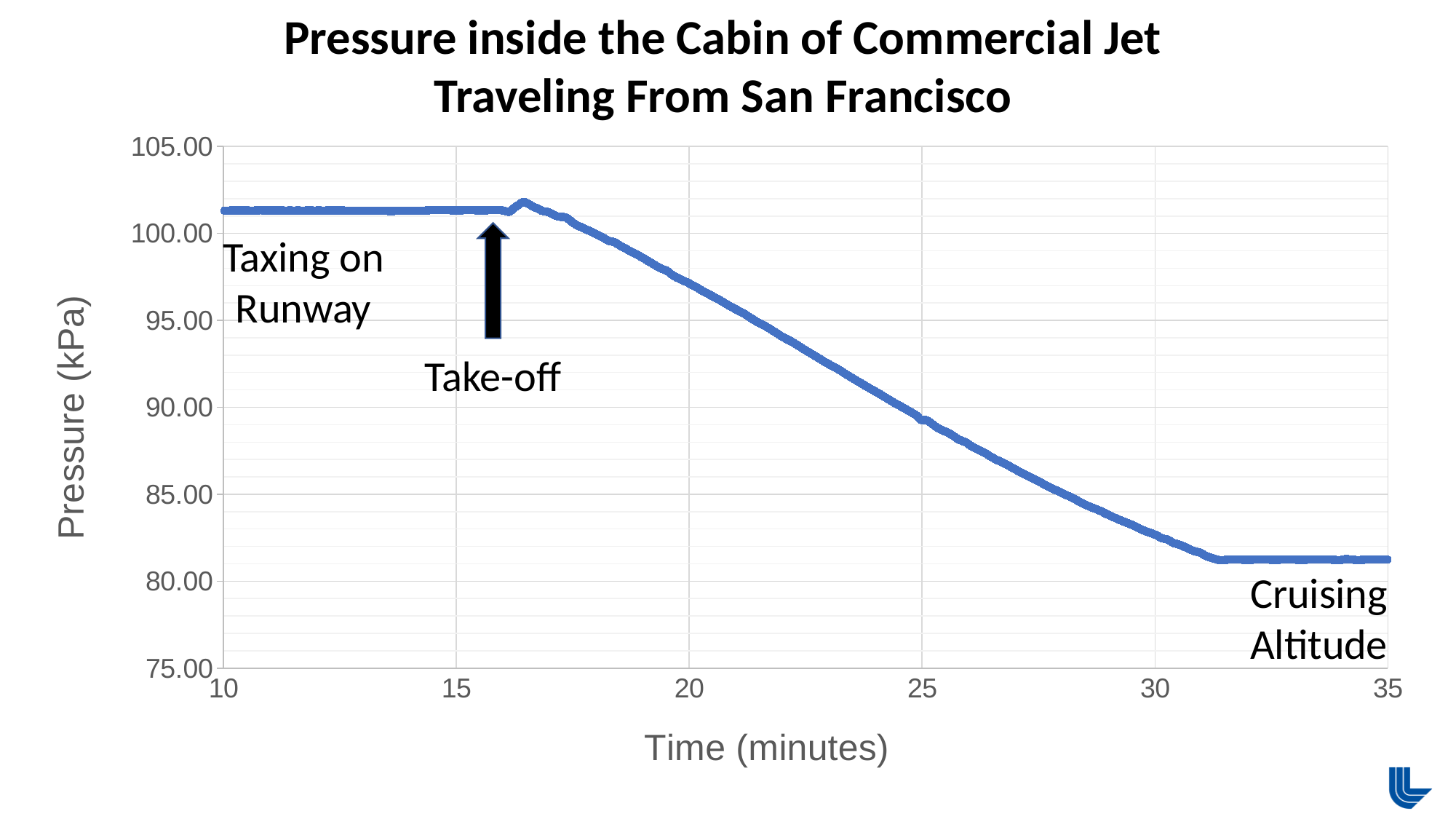
Which is higher, the pressure at 10 minutes or the pressure at 35 minutes? 10 minutes Is the pressure at 15 minutes greater or less than 100.00 kPa? greater What kind of chart is shown on the slide? line chart Is the pressure at 25 minutes greater or less than 95.00 kPa? less Is the pressure at 20 minutes greater or less than 95.00 kPa? greater Between 20 and 30 minutes, does the pressure rise or fall? fall Between 10 and 15 minutes, does the pressure rise, fall, or stay roughly flat? stay roughly flat What is the title of the chart? Pressure inside the Cabin of Commercial Jet Traveling From San Francisco What event does the black arrow on the chart mark? Take-off